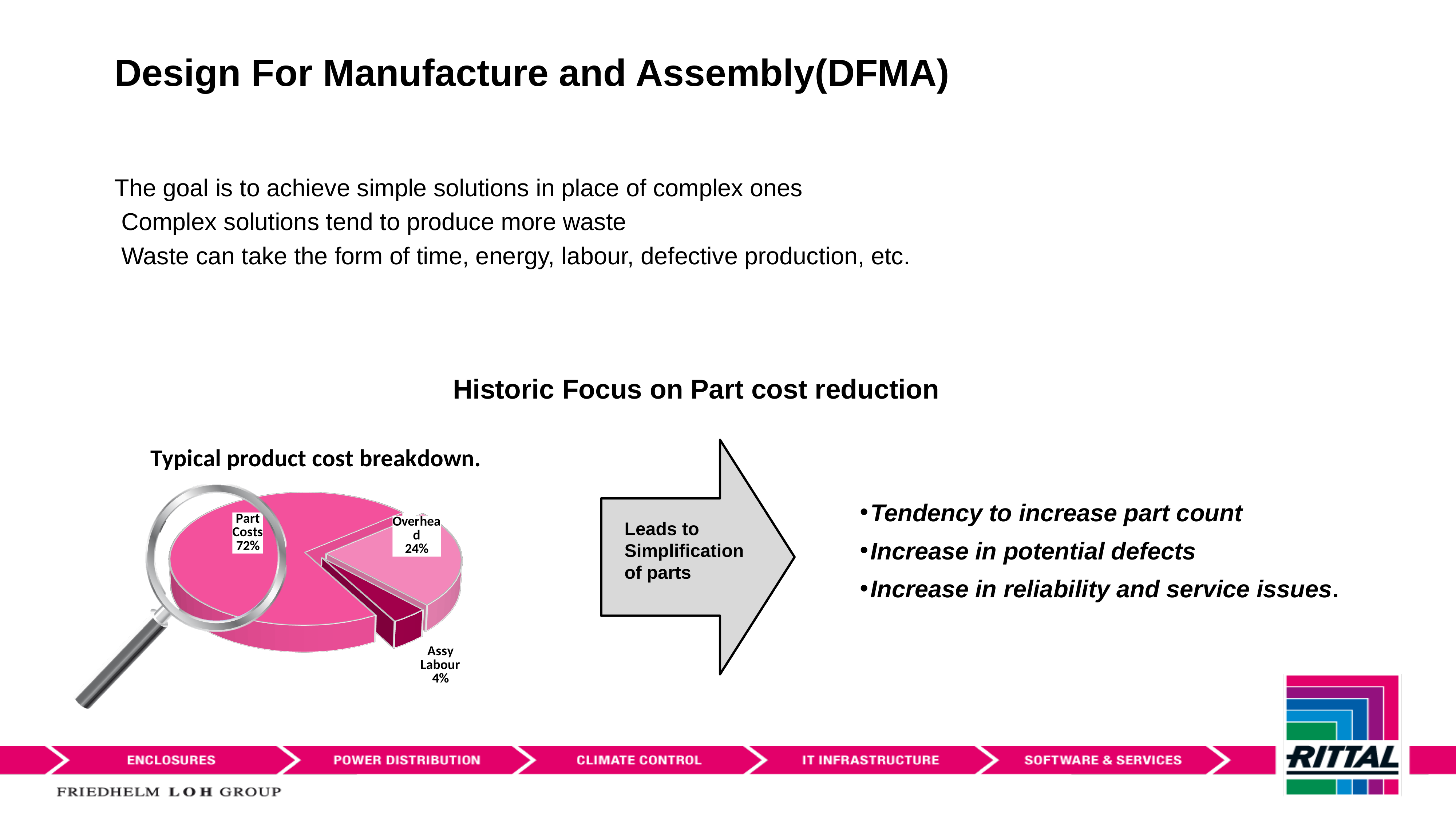
Which is larger, the Overhead share or the Assy Labour share? Overhead What percentage of the product cost is Part Costs? 72% What percentage of the product cost is Overhead? 24% Which category has the largest share of the product cost? Part Costs What type of chart is shown under 'Typical product cost breakdown.'? Pie chart What percentage of the product cost is Assy Labour? 4% What is the difference between the Part Costs share and the Overhead share? 48% Which slice of the pie chart is highlighted by the magnifying glass? Part Costs What is the title of the pie chart? Typical product cost breakdown. How many slices does the pie chart have? 3 Which category has the smallest share of the product cost? Assy Labour What is the difference between the Overhead share and the Assy Labour share? 20%